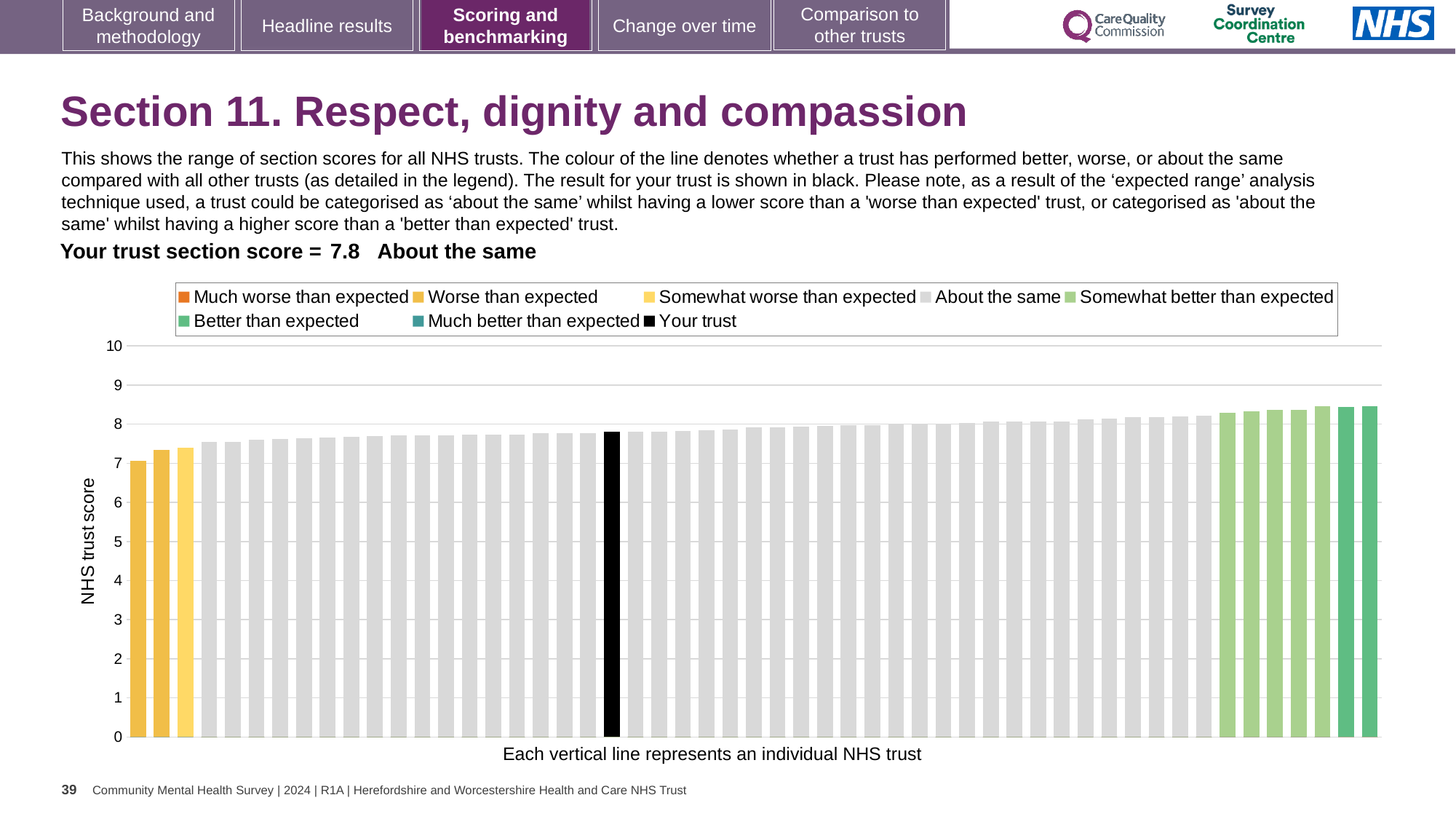
How many entries does the chart legend list? 8 According to the legend, what colour is used for 'Your trust'? black What kind of chart is shown on the slide? bar chart Is the value for the rightmost bar greater or less than 8? greater What is the label on the vertical axis of the chart? NHS trust score Is the value for the leftmost bar greater or less than 8? less How is your trust categorised compared with other trusts in this section? About the same Do the bar values rise or fall from left to right across the chart? rise Is the leftmost bar higher or lower than the black bar for your trust? lower Is the value for your trust (the black bar) greater or less than 7? greater What is your trust's section score for Section 11, Respect, dignity and compassion? 7.8